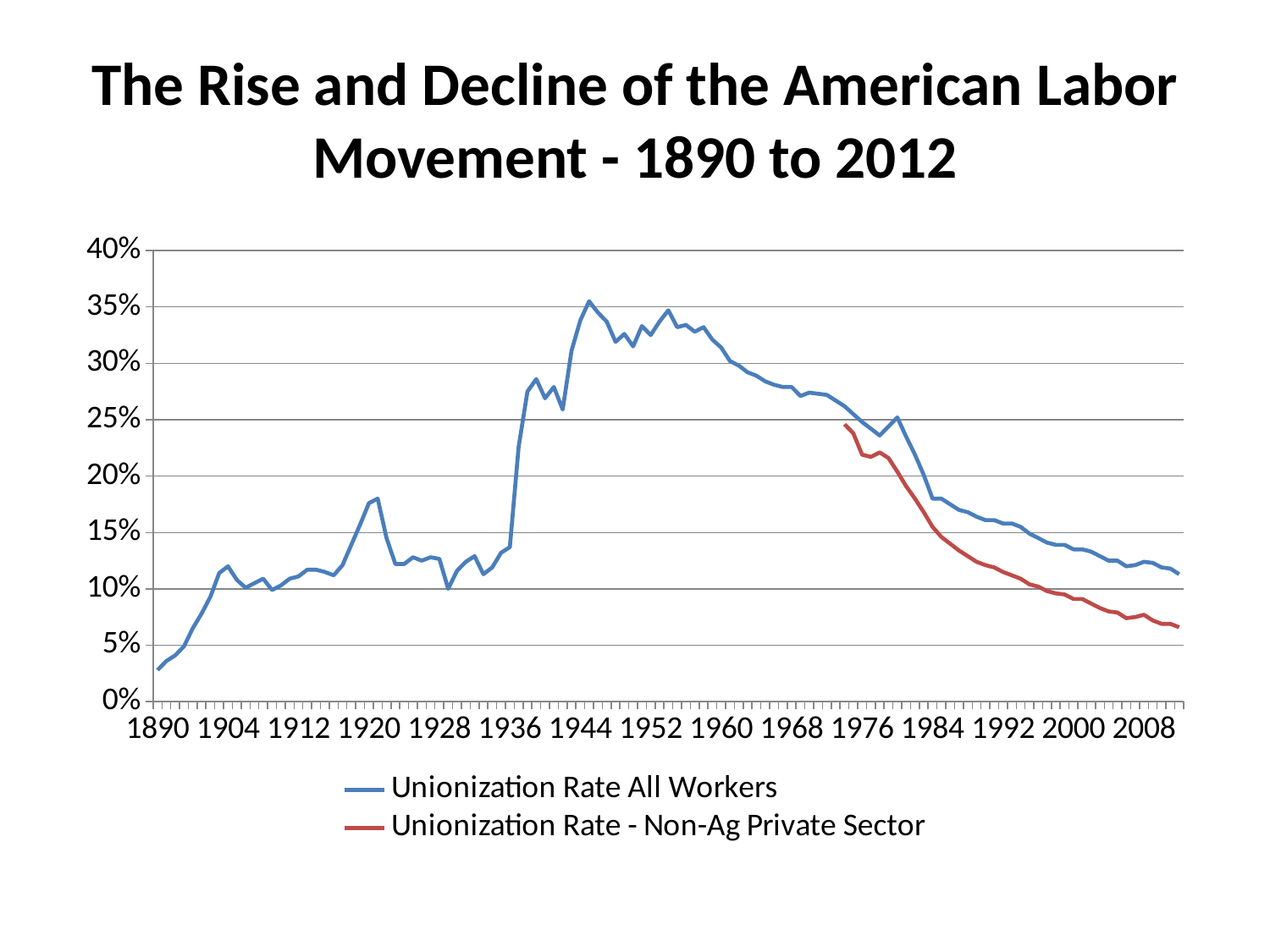
Does the Unionization Rate All Workers rise or fall from 1890 to 1904? rise Which series is drawn with the red line? Unionization Rate - Non-Ag Private Sector Is the Unionization Rate All Workers in 1920 greater or less than 15%? greater Is the Unionization Rate - Non-Ag Private Sector in 1976 greater or less than 20%? greater What kind of chart is shown on the slide? line chart Is the Unionization Rate All Workers in 1890 greater or less than 5%? less Does the Unionization Rate All Workers rise or fall from 1984 to 2012? fall In 2008, which series has the higher value, Unionization Rate All Workers or Unionization Rate - Non-Ag Private Sector? Unionization Rate All Workers What is the title of the chart? The Rise and Decline of the American Labor Movement - 1890 to 2012 How many series does the legend list? 2